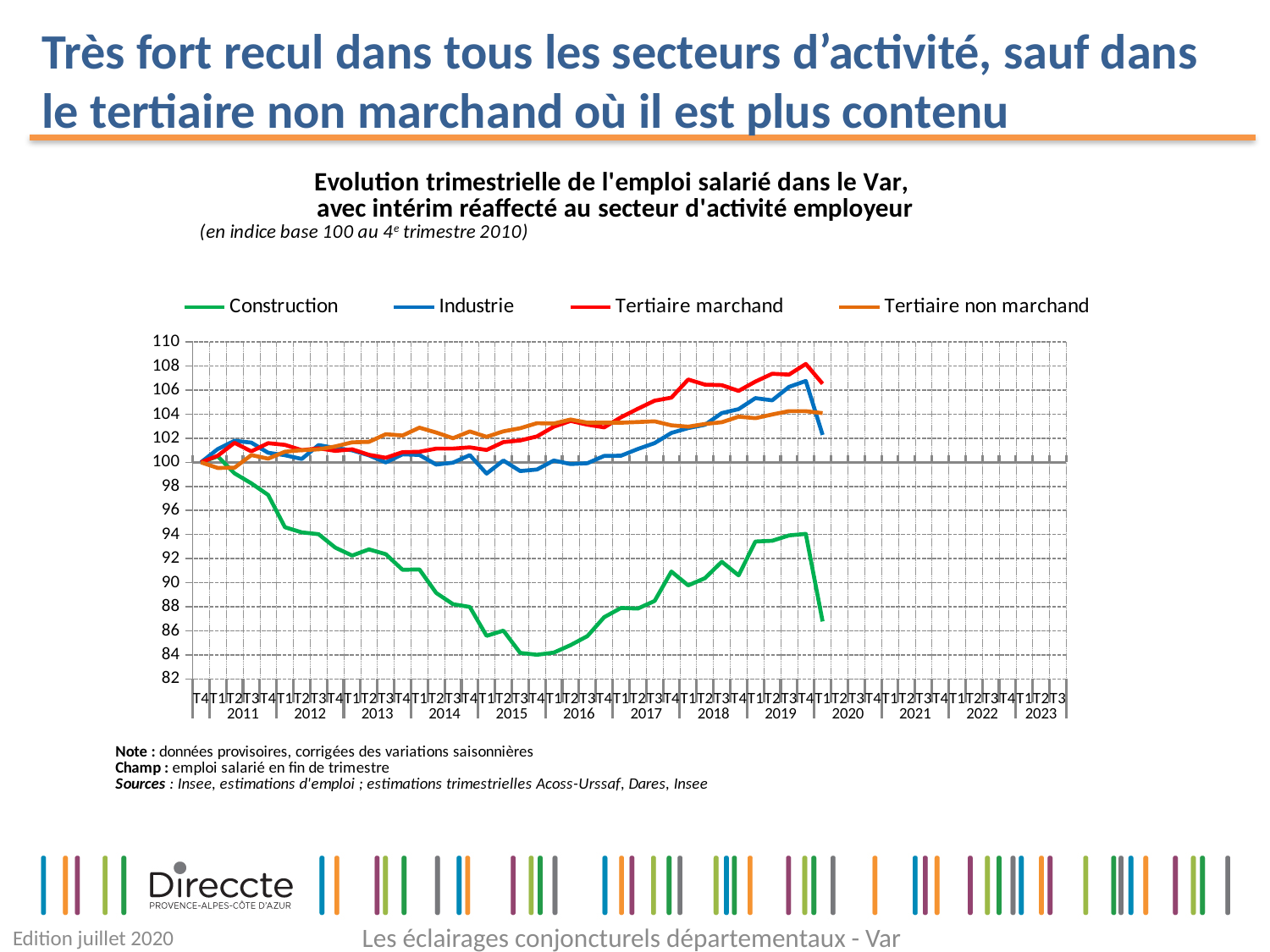
What is the base value of the index at the 4th quarter of 2010? 100 Is the value for Industrie at T4 2019 greater or less than 104? greater Is the value for Construction at T1 2020 greater or less than 90? less What kind of chart is shown on the slide? line chart Does the Construction series rise or fall between 2011 and 2015? fall Is the peak value of Tertiaire marchand at the end of 2019 greater or less than 106? greater Does the Tertiaire marchand series rise or fall between 2011 and 2019? rise At T1 2020, which is larger: Industrie or Construction? Industrie How many series does the legend list? 4 Which series has the lowest value at the last plotted point (T1 2020)? Construction Which series is plotted in green? Construction